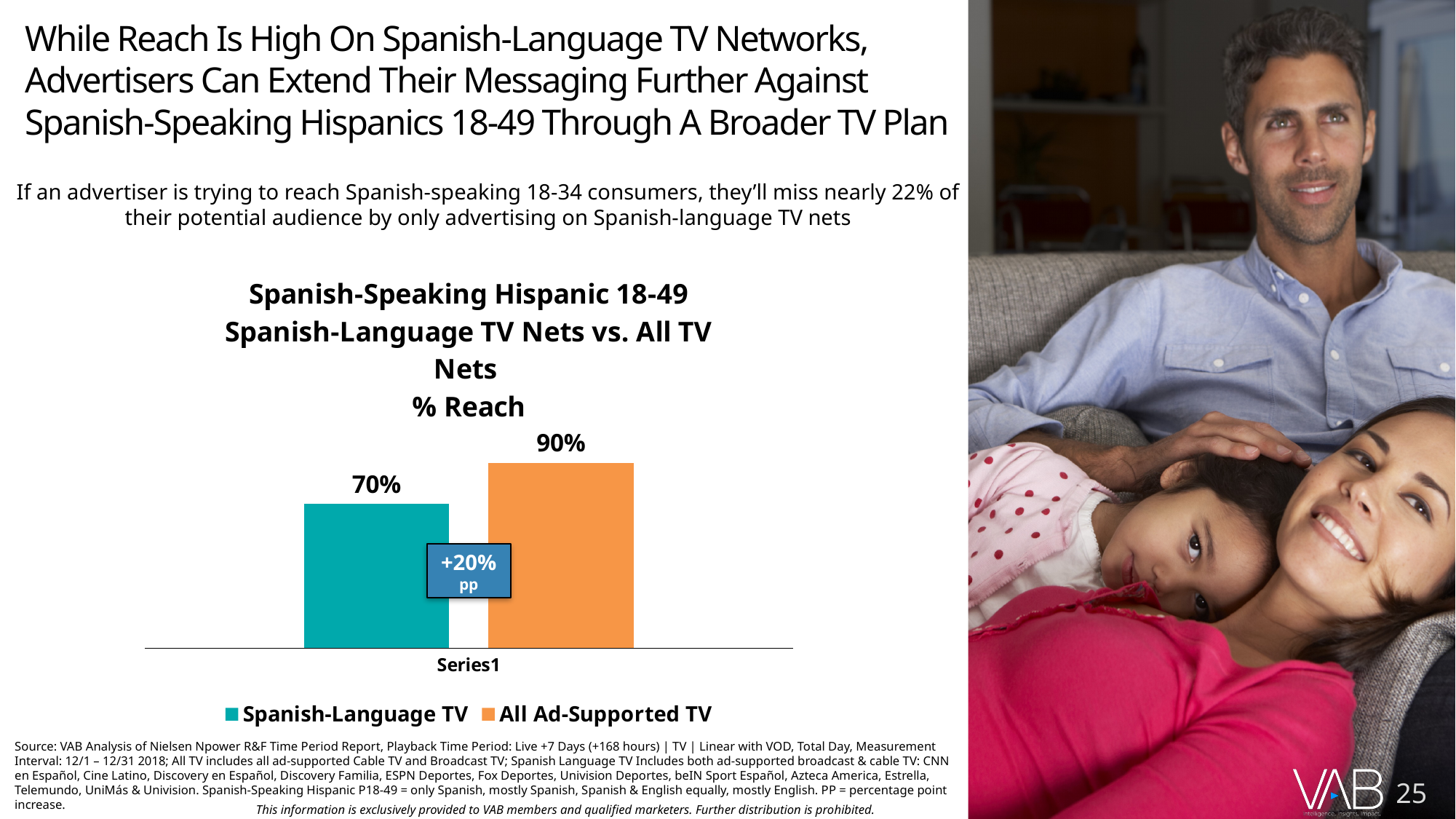
How many bars are plotted in the chart? 2 What is the % reach for Spanish-Language TV? 70% Which series has the lower % reach? Spanish-Language TV What value is shown in the blue callout box between the two bars? +20% pp What is the difference in % reach between All Ad-Supported TV and Spanish-Language TV? 20 percentage points What colour is the bar for All Ad-Supported TV? orange What is the % reach for All Ad-Supported TV? 90% Is the % reach for Spanish-Language TV larger or smaller than that for All Ad-Supported TV? smaller What kind of chart is shown on the slide? bar chart Which series has the higher % reach? All Ad-Supported TV How many series does the legend list? 2